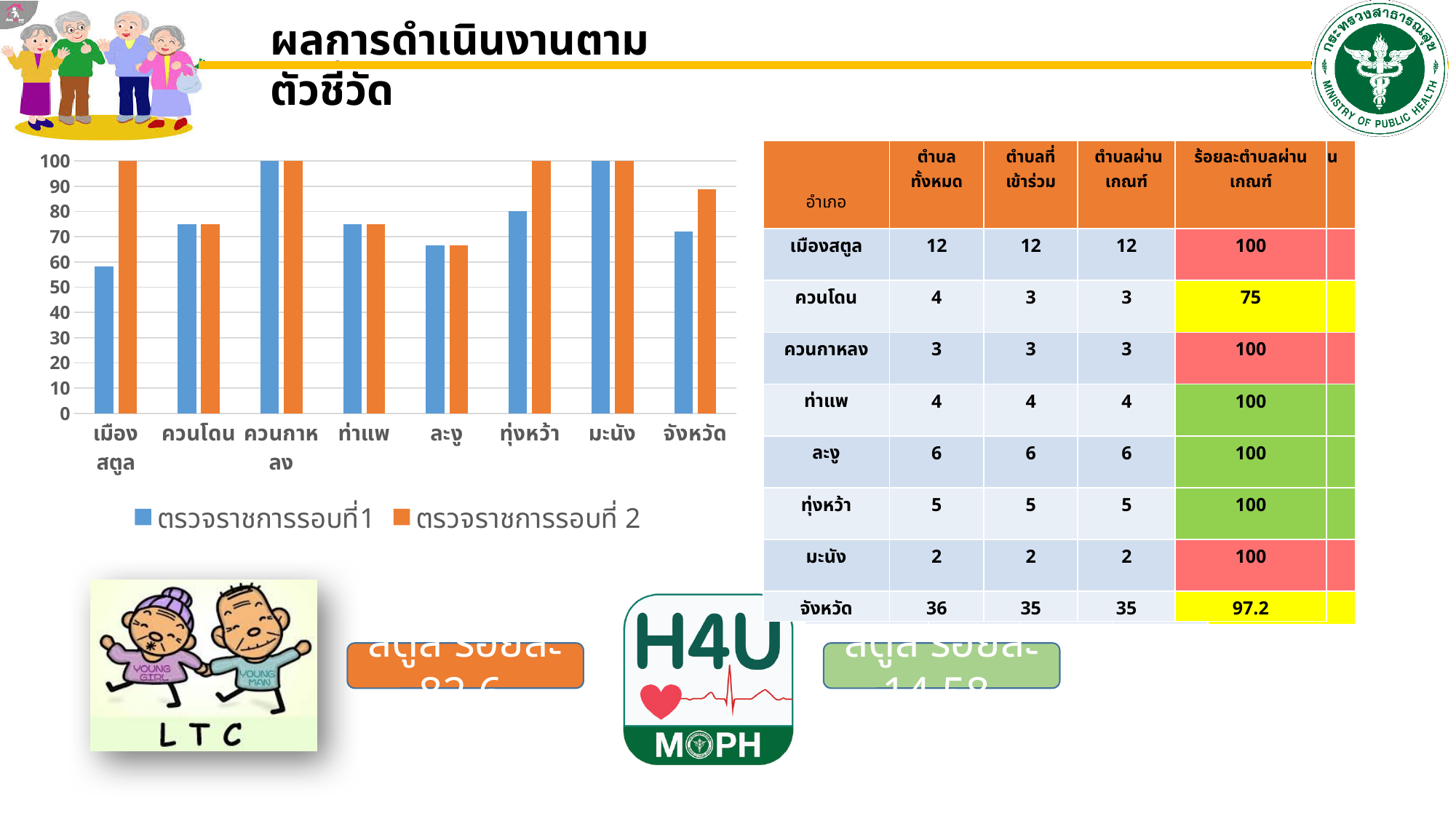
What is the value of ตรวจราชการรอบที่1 for ควนกาหลง in the bar chart? 100 For เมืองสตูล, which series has the larger value, ตรวจราชการรอบที่1 or ตรวจราชการรอบที่ 2? ตรวจราชการรอบที่ 2 What is the value of ตรวจราชการรอบที่ 2 for เมืองสตูล in the bar chart? 100 Which category has the lowest value for ตรวจราชการรอบที่ 2? ละงู Is the value of ตรวจราชการรอบที่1 for เมืองสตูล greater or less than 50? greater How many series does the chart legend list? 2 What kind of chart is shown on the slide? bar chart Which category has the lowest value for ตรวจราชการรอบที่1? เมืองสตูล Is the value of ตรวจราชการรอบที่ 2 for จังหวัด greater or less than 80? greater Is the value of ตรวจราชการรอบที่1 for ละงู greater or less than 70? less How many categories are shown on the x axis of the bar chart? 8 What is the value of ตรวจราชการรอบที่ 2 for มะนัง in the bar chart? 100